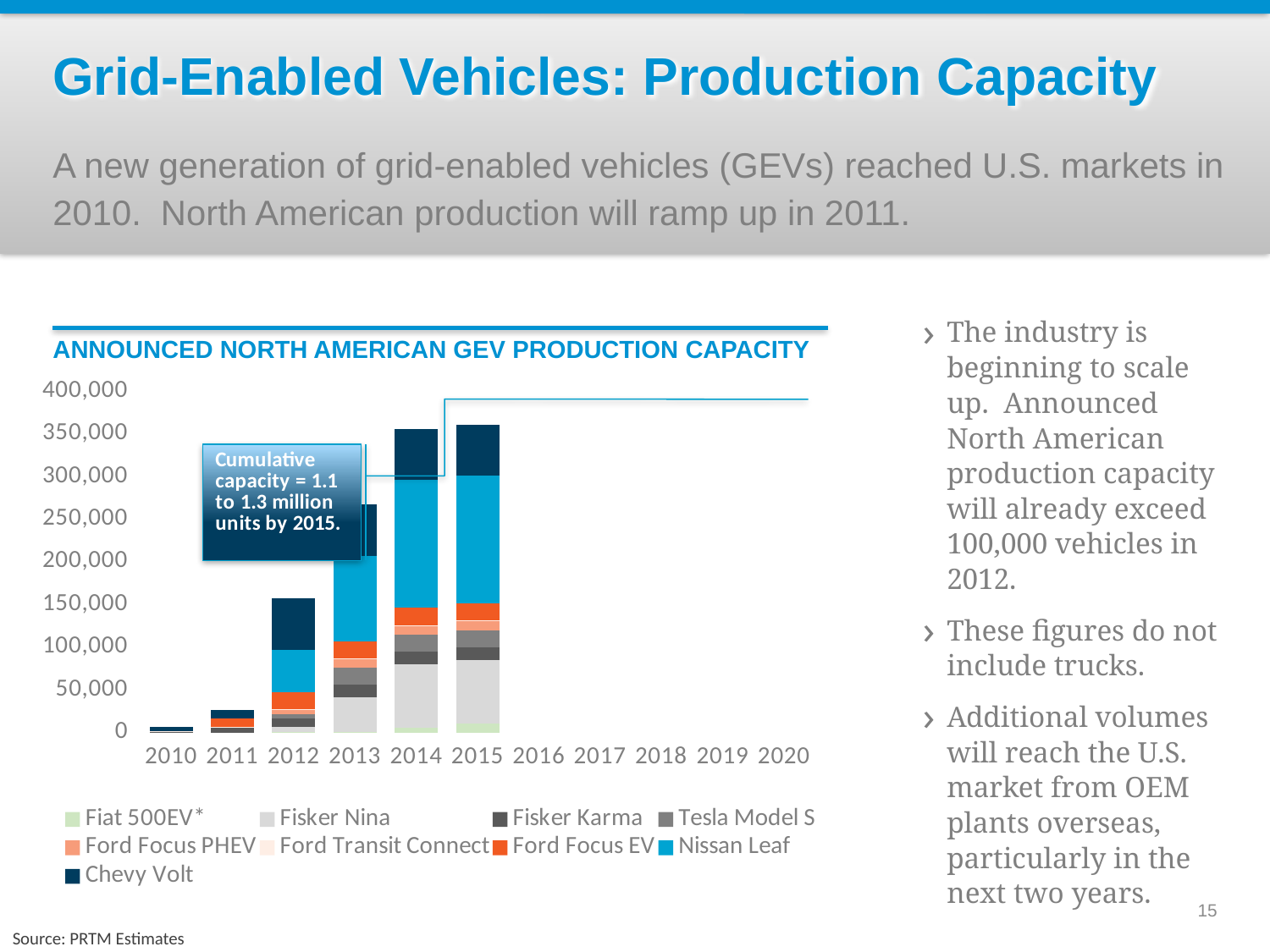
Is the total value for 2013 greater or less than 200,000? greater What cumulative capacity by 2015 does the callout box on the chart state? 1.1 to 1.3 million units How many series does the legend of the chart list? 9 How many years are labelled on the x axis of the chart? 11 What is the title of the chart? ANNOUNCED NORTH AMERICAN GEV PRODUCTION CAPACITY What kind of chart is shown on the slide? Stacked bar chart For how many years does the chart show a plotted bar? 6 Which year has the larger total capacity, 2012 or 2013? 2013 Is the total value for 2011 greater or less than 50,000? less Do the bar totals rise or fall from 2010 to 2015? Rise Is the total value for 2014 greater or less than 300,000? greater Which year has the lowest total announced production capacity? 2010